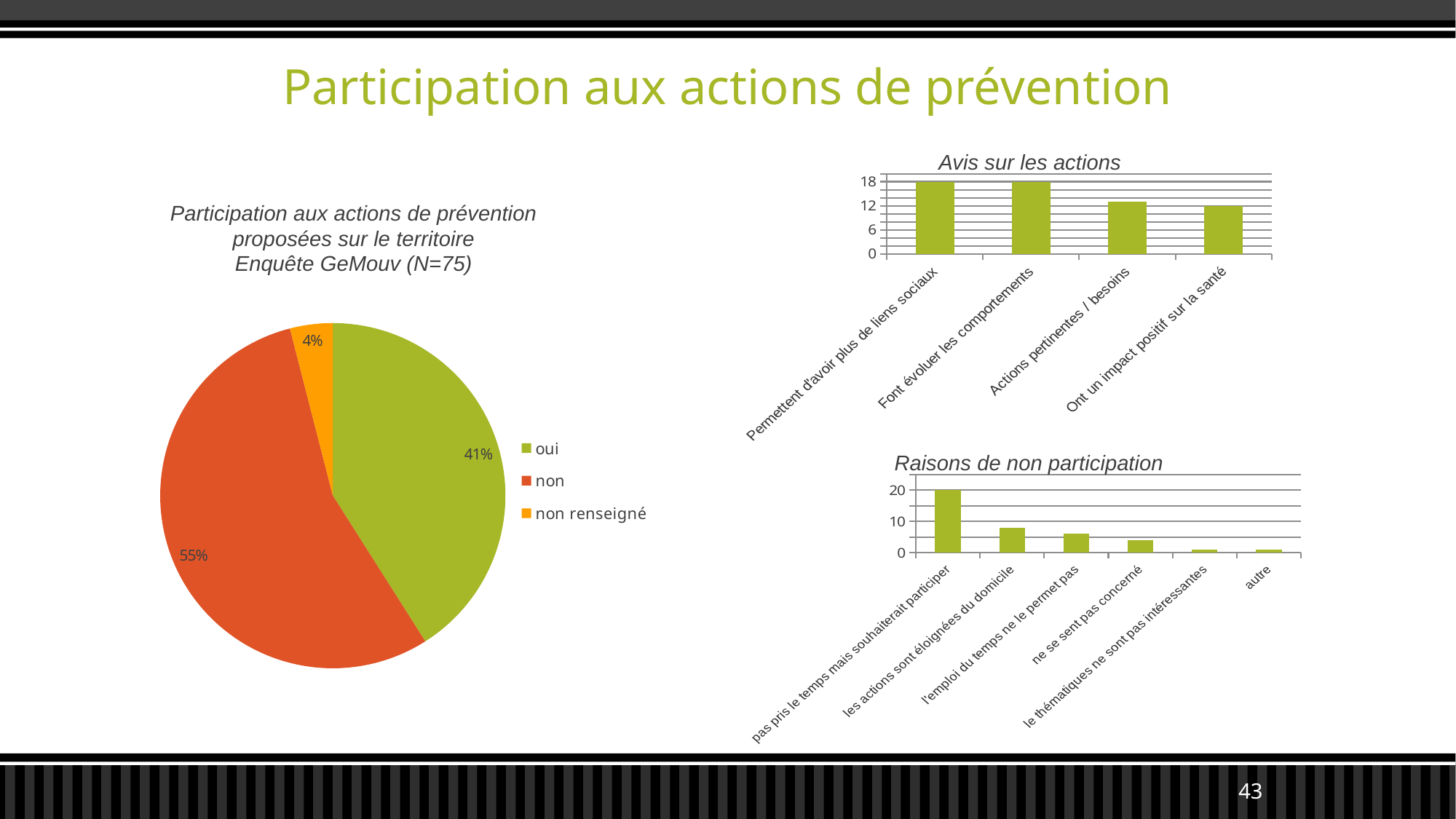
In the pie chart on the left, which category has the largest share? non In the "Raisons de non participation" chart, is the value for "les actions sont éloignées du domicile" greater or less than 10? less In the pie chart on the left, what percentage is shown for "non"? 55% In the pie chart on the left, what is the difference in percentage points between "non" and "oui"? 14 What kind of chart is "Raisons de non participation"? bar chart In the pie chart on the left, what percentage is shown for "oui"? 41% In the "Avis sur les actions" chart, which is larger: "Permettent d'avoir plus de liens sociaux" or "Ont un impact positif sur la santé"? Permettent d'avoir plus de liens sociaux In the pie chart on the left, which category has the smallest share? non renseigné How many categories does the legend of the pie chart on the left list? 3 In the "Avis sur les actions" chart, how many categories are shown on the x axis? 4 In the "Raisons de non participation" chart, which category has the highest value? pas pris le temps mais souhaiterait participer In the "Avis sur les actions" chart, is the value for "Actions pertinentes / besoins" greater or less than 12? greater